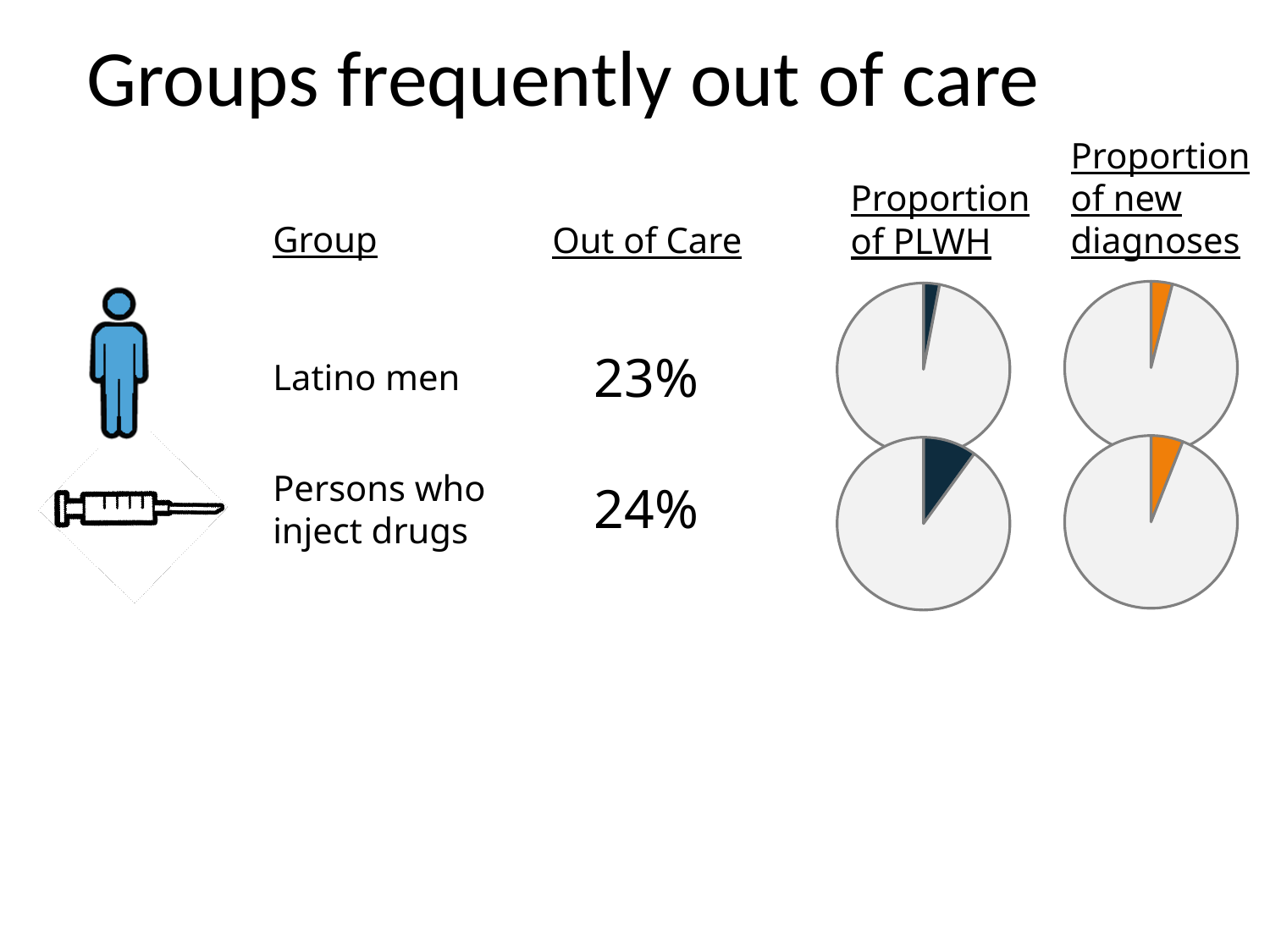
For persons who inject drugs, which pie chart has the larger highlighted slice, Proportion of PLWH or Proportion of new diagnoses? Proportion of PLWH In the Proportion of PLWH pie charts, which group has the larger highlighted slice, Latino men or persons who inject drugs? Persons who inject drugs For Latino men, which pie chart has the larger highlighted slice, Proportion of PLWH or Proportion of new diagnoses? Proportion of new diagnoses How many pie charts are shown on the slide? 4 What colour is the highlighted slice in the Proportion of PLWH pie charts? Dark blue What colour is the highlighted slice in the Proportion of new diagnoses pie charts? Orange What kind of chart is used to show the Proportion of PLWH for Latino men? Pie chart Is the highlighted slice in the Proportion of PLWH pie chart for persons who inject drugs greater or less than 50% of the pie? less How many slices does each pie chart on the slide have? 2